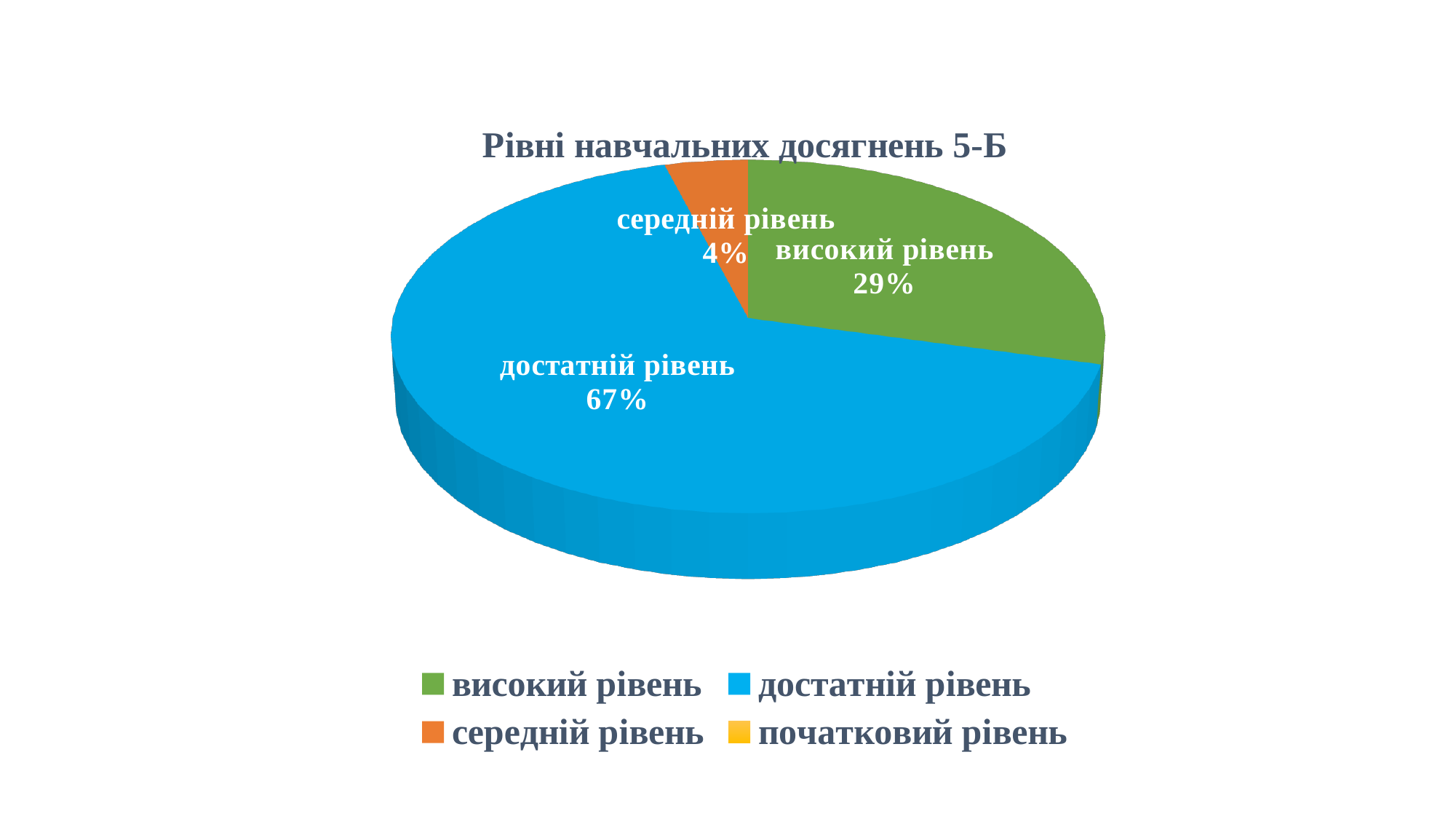
What is the value shown for середній рівень? 4% How many slices with data labels are shown in the pie? 3 How many entries does the legend list? 4 What kind of chart is shown on the slide? pie chart What is the value shown for високий рівень? 29% Which is larger, високий рівень or середній рівень? високий рівень Which level has the largest slice of the pie? достатній рівень What is the title of the chart? Рівні навчальних досягнень 5-Б What share of the pie does достатній рівень take? 67% What is the difference between достатній рівень and високий рівень? 38% Which labelled slice is the smallest? середній рівень What is the difference between високий рівень and середній рівень? 25%